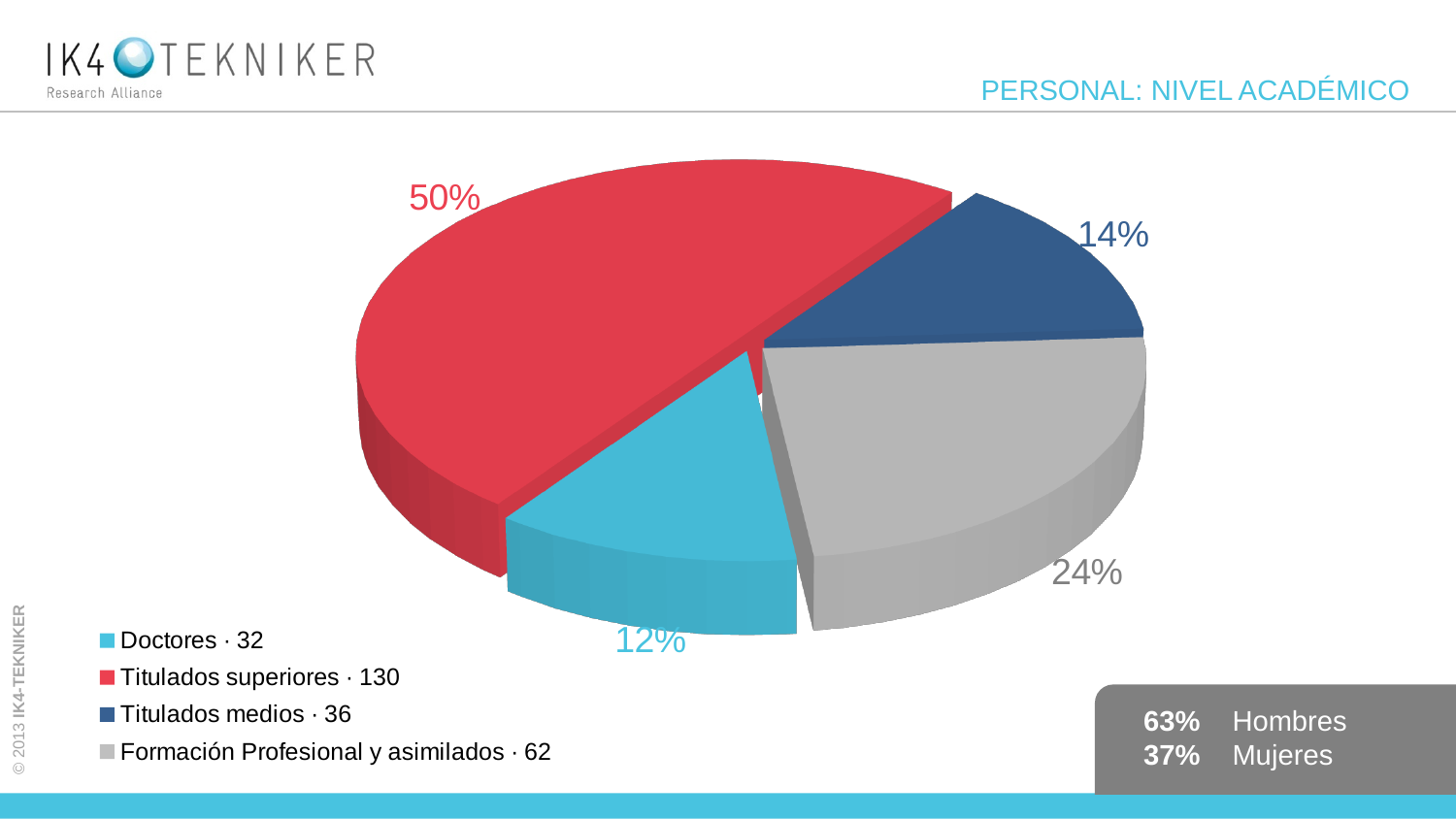
What percentage of the pie does the Doctores slice represent? 12% Which category has the smallest slice of the pie? Doctores What is the count shown in the legend for Titulados superiores? 130 What percentage of the pie does the Formación Profesional y asimilados slice represent? 24% What kind of chart is shown on the slide? pie chart Which colour represents Titulados medios in the pie chart? dark blue How many categories does the pie chart have? 4 What percentage of the pie does the Titulados medios slice represent? 14% What is the count shown in the legend for Formación Profesional y asimilados? 62 What is the difference in percentage points between the Titulados superiores slice and the Formación Profesional y asimilados slice? 26% Which category has the largest slice of the pie? Titulados superiores